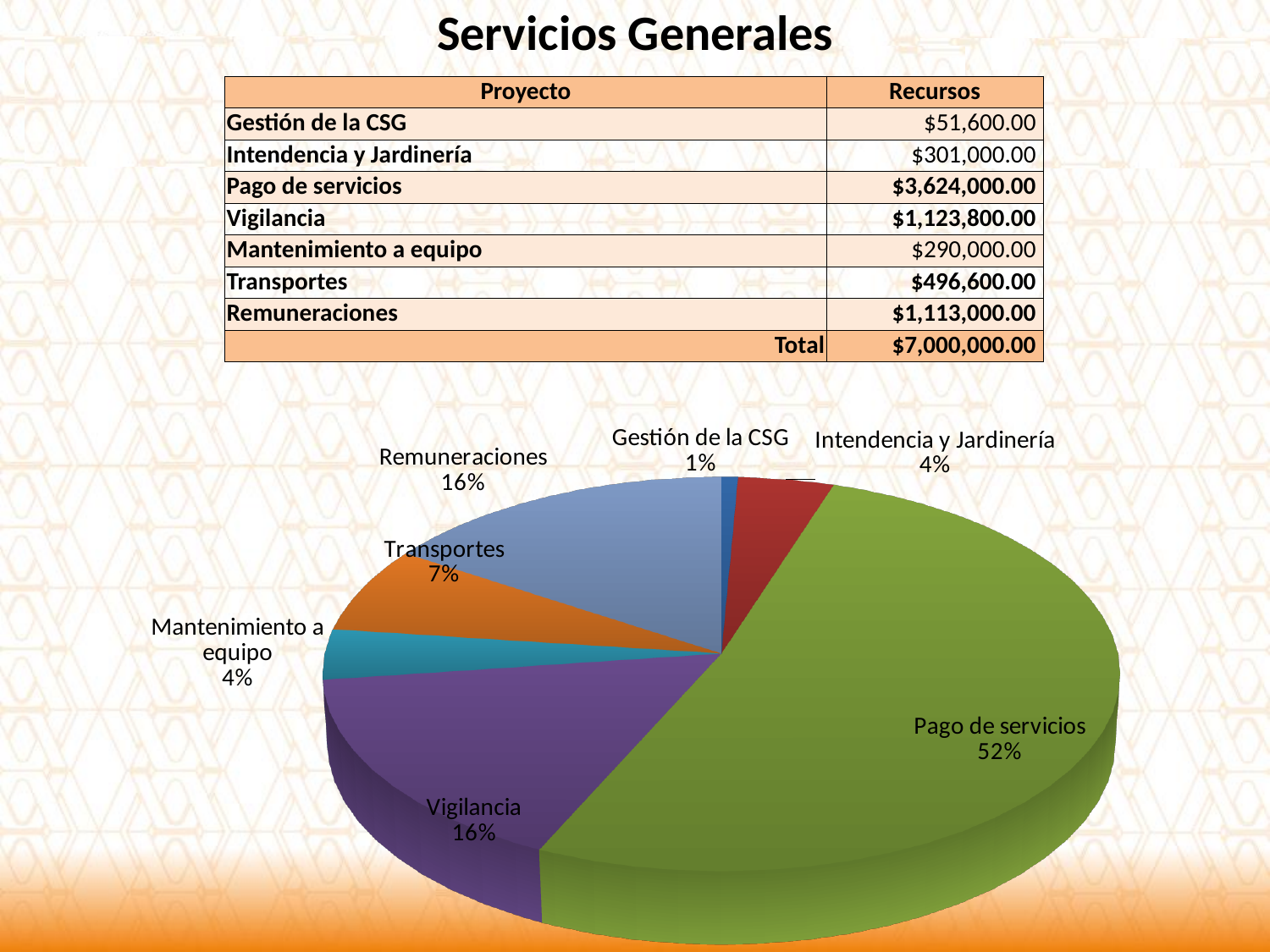
Which category has the largest slice of the pie chart? Pago de servicios What colour is the Pago de servicios slice in the pie chart? green Which category has the smallest slice of the pie chart? Gestión de la CSG What percentage is shown for Transportes in the pie chart? 7% Which slice is larger in the pie chart, Transportes or Remuneraciones? Remuneraciones What share of the pie does Pago de servicios represent? 52% What percentage is shown for Gestión de la CSG in the pie chart? 1% What percentage is shown for Mantenimiento a equipo in the pie chart? 4% What kind of chart is shown on the slide? pie chart What is the difference in percentage points between the Pago de servicios slice and the Vigilancia slice? 36 How many slices does the pie chart have? 7 What percentage is shown for Vigilancia in the pie chart? 16%